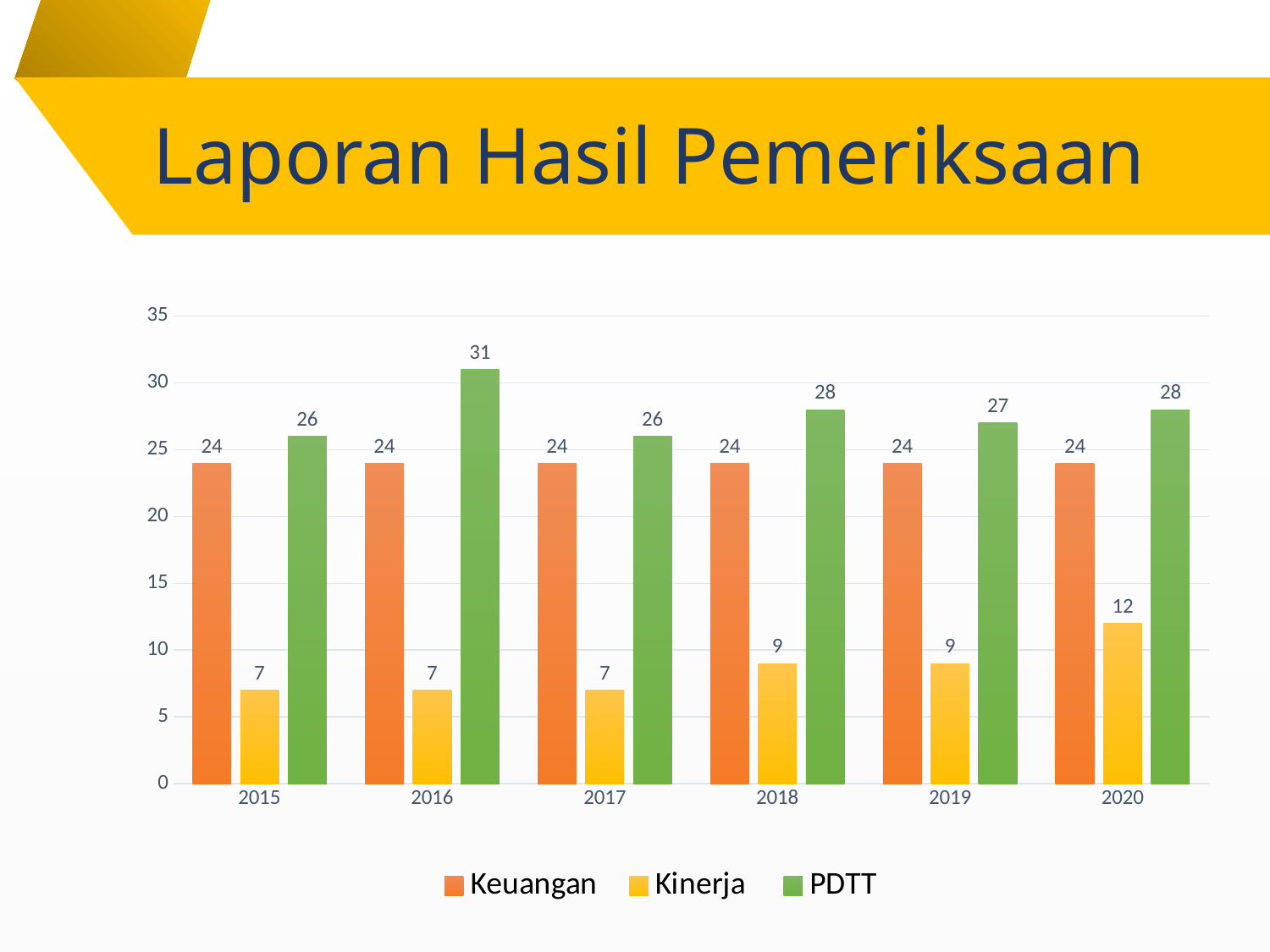
Which is larger in 2019, the PDTT value or the Keuangan value? PDTT In which year is the PDTT value highest? 2016 What kind of chart is shown on the slide? Bar chart What is the value for Keuangan in 2018? 24 What is the value for Kinerja in 2020? 12 How many years are shown on the x axis? 6 What is the difference between the PDTT value and the Keuangan value in 2016? 7 What is the difference between the Kinerja values in 2020 and 2019? 3 What is the value for PDTT in 2016? 31 In which year is the Kinerja value highest? 2020 Which series is shown in green in the legend? PDTT How many series does the legend list? 3